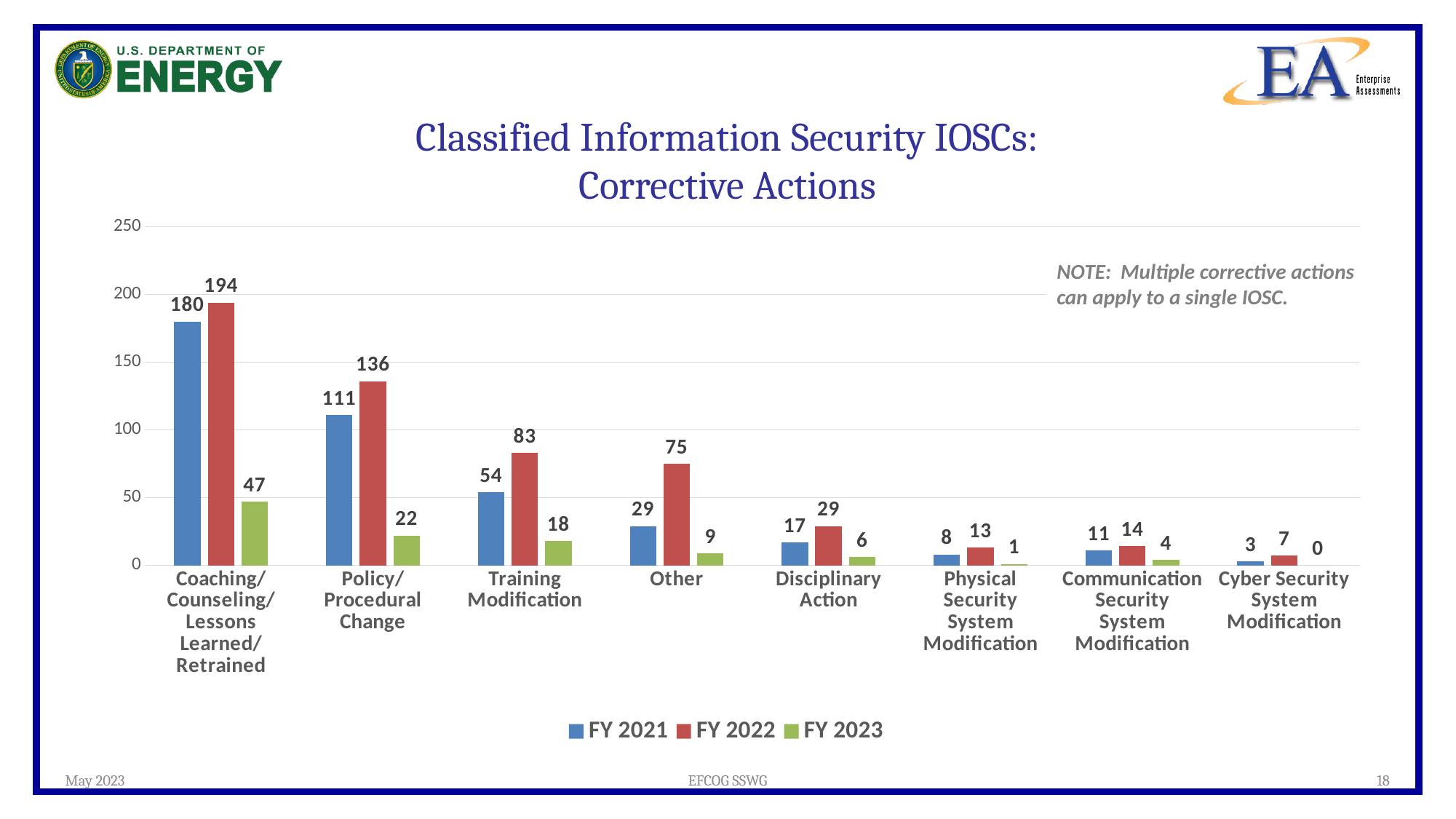
Which is larger for Disciplinary Action: the FY 2021 value or the FY 2022 value? FY 2022 How many categories are shown on the x axis? 8 How many series does the legend list? 3 What kind of chart is shown on the slide? Bar chart Which category has the highest FY 2022 value? Coaching/Counseling/Lessons Learned/Retrained What is the difference between the FY 2022 and FY 2021 values for Other? 46 Which category has the lowest FY 2023 value? Cyber Security System Modification What is the FY 2022 value for Policy/Procedural Change? 136 Do the FY 2021 values rise or fall from left to right across the categories? Fall What is the title of the chart? Classified Information Security IOSCs: Corrective Actions What is the FY 2023 value for Coaching/Counseling/Lessons Learned/Retrained? 47 What is the FY 2021 value for Training Modification? 54